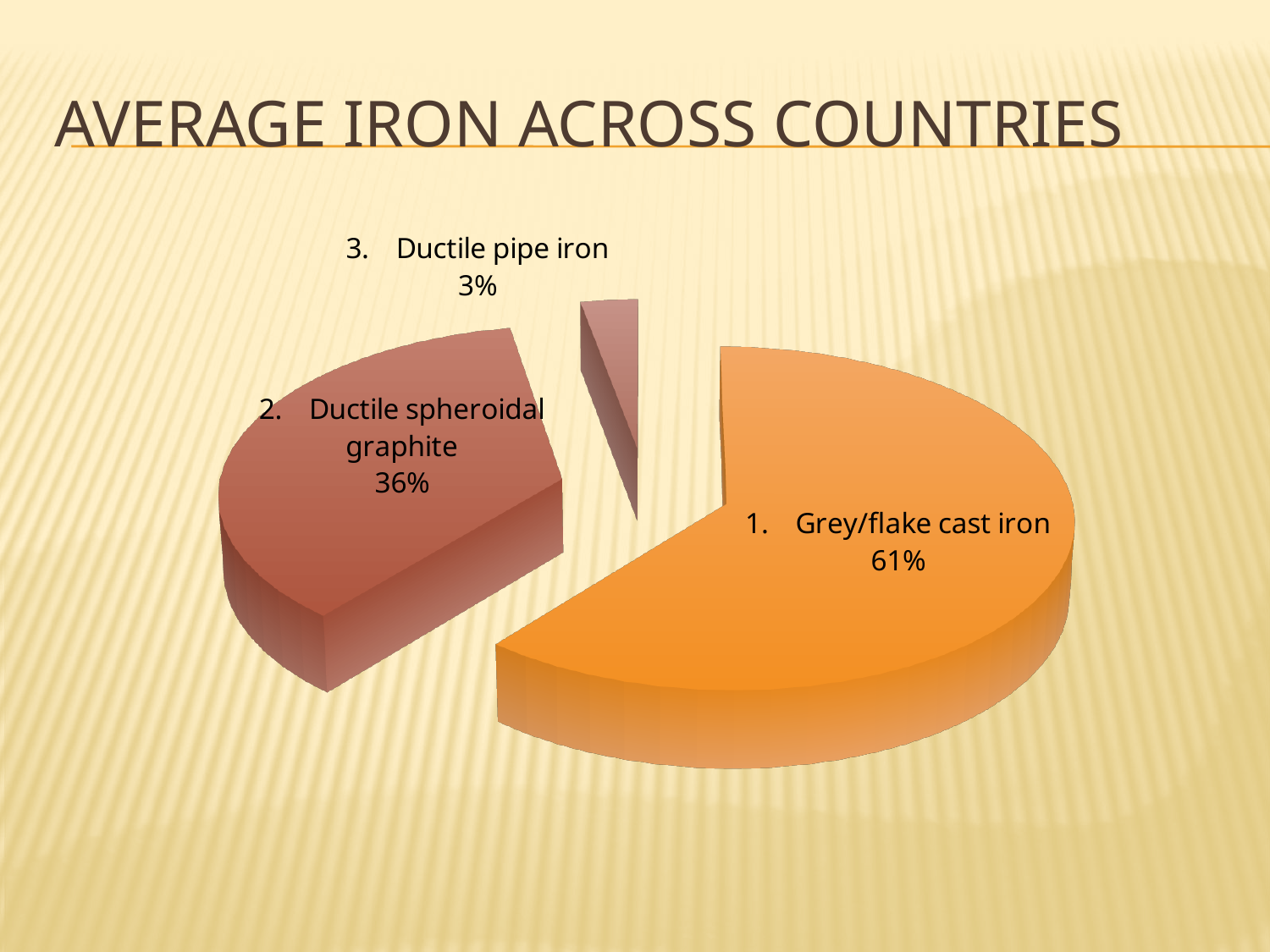
What is the difference in percentage points between Ductile spheroidal graphite and Ductile pipe iron? 33 What share of the pie does Grey/flake cast iron have? 61% Which is larger, the share for Ductile spheroidal graphite or the share for Ductile pipe iron? Ductile spheroidal graphite Which category has the largest share of the pie? Grey/flake cast iron How many slices does the pie chart have? 3 What is the title of the slide? AVERAGE IRON ACROSS COUNTRIES Which category has the smallest share of the pie? Ductile pipe iron What share of the pie does Ductile spheroidal graphite have? 36% What share of the pie does Ductile pipe iron have? 3% What is the difference in percentage points between Grey/flake cast iron and Ductile spheroidal graphite? 25 What colour is the Grey/flake cast iron slice? Orange What kind of chart is shown on the slide? Pie chart